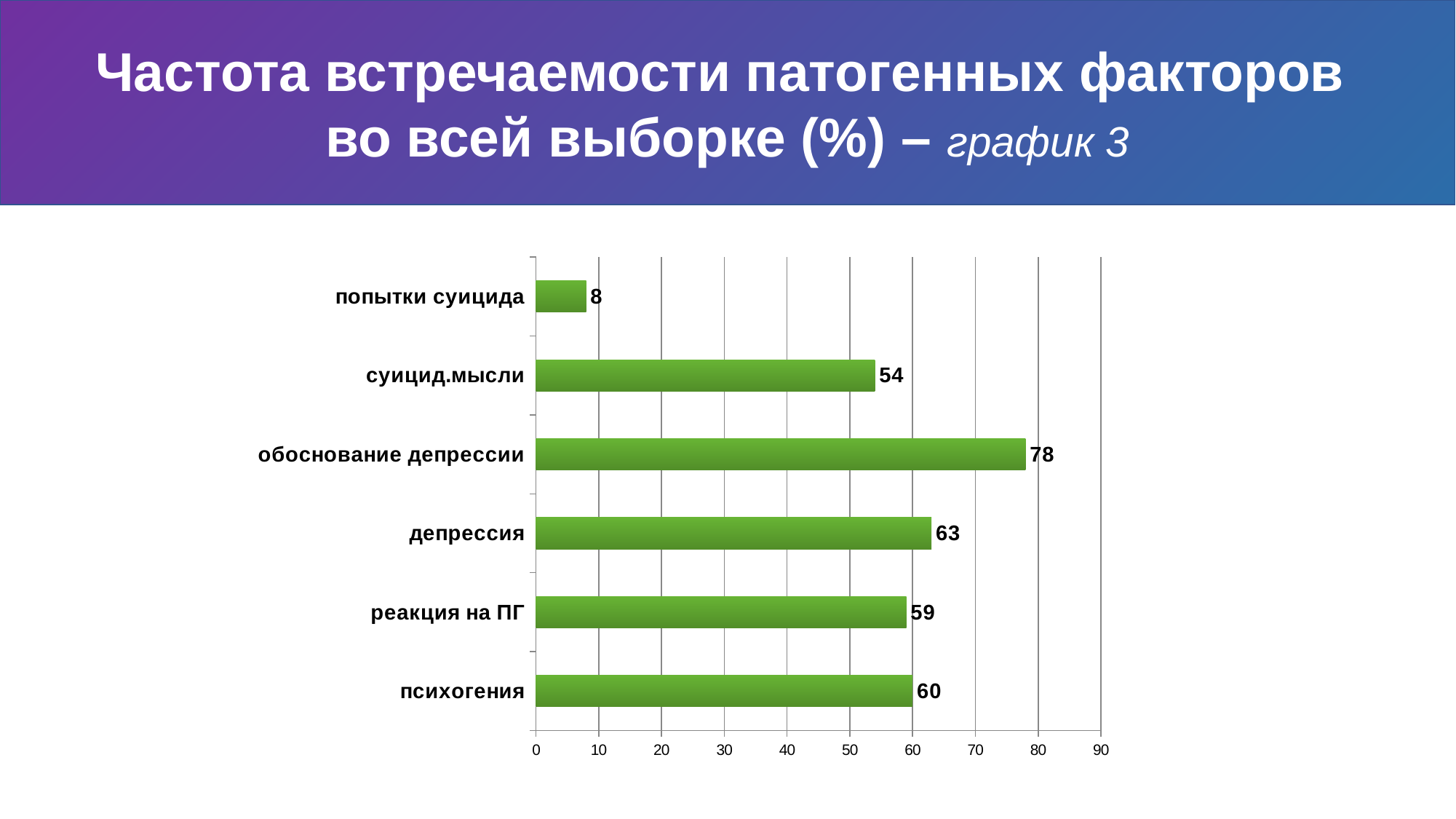
What is the value for реакция на ПГ? 59 How many categories are shown in the chart? 6 Which category has the lowest value? попытки суицида Which is larger, the value for депрессия or the value for суицид.мысли? депрессия What kind of chart is shown on the slide? bar chart What is the maximum value shown on the horizontal axis? 90 What is the difference between the values for обоснование депрессии and депрессия? 15 What is the value for психогения? 60 What is the difference between the values for суицид.мысли and попытки суицида? 46 Which category has the highest value? обоснование депрессии What is the value for попытки суицида? 8 What is the value for обоснование депрессии? 78